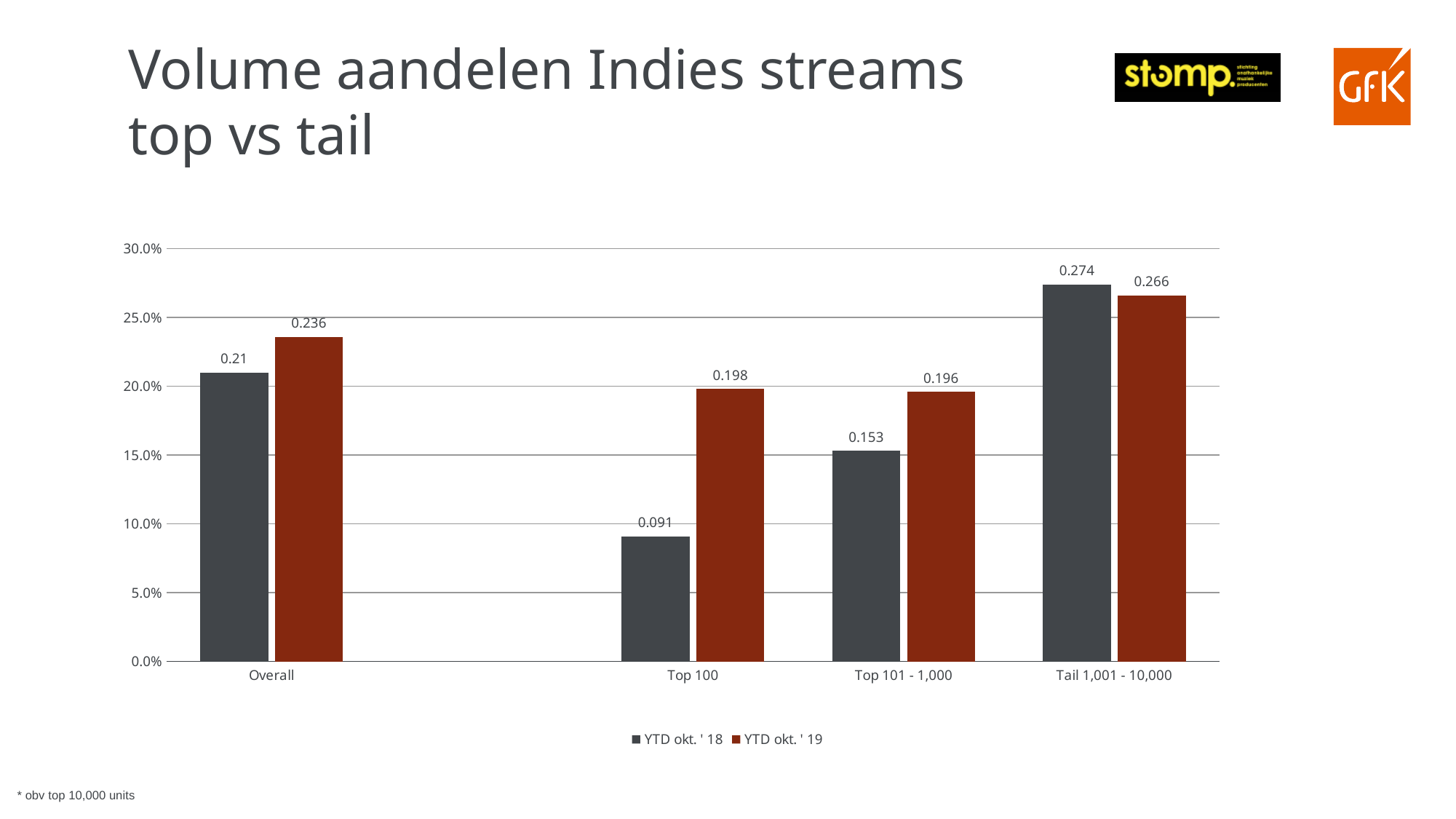
What is the difference between the YTD okt. ' 19 and YTD okt. ' 18 values for Top 100? 0.107 What is the value for Tail 1,001 - 10,000 in the YTD okt. ' 18 series? 0.274 Which category has the highest value in the YTD okt. ' 19 series? Tail 1,001 - 10,000 What kind of chart is shown on the slide? bar chart Which category has the lowest value in the YTD okt. ' 18 series? Top 100 How many categories are shown on the x axis? 4 Is the YTD okt. ' 18 value for Top 100 greater or less than 10.0%? less What is the value for Overall in the YTD okt. ' 18 series? 0.21 Which is larger for Top 101 - 1,000: the YTD okt. ' 18 value or the YTD okt. ' 19 value? YTD okt. ' 19 How many series does the legend list? 2 What is the value for Top 100 in the YTD okt. ' 19 series? 0.198 What is the title of the slide? Volume aandelen Indies streams top vs tail